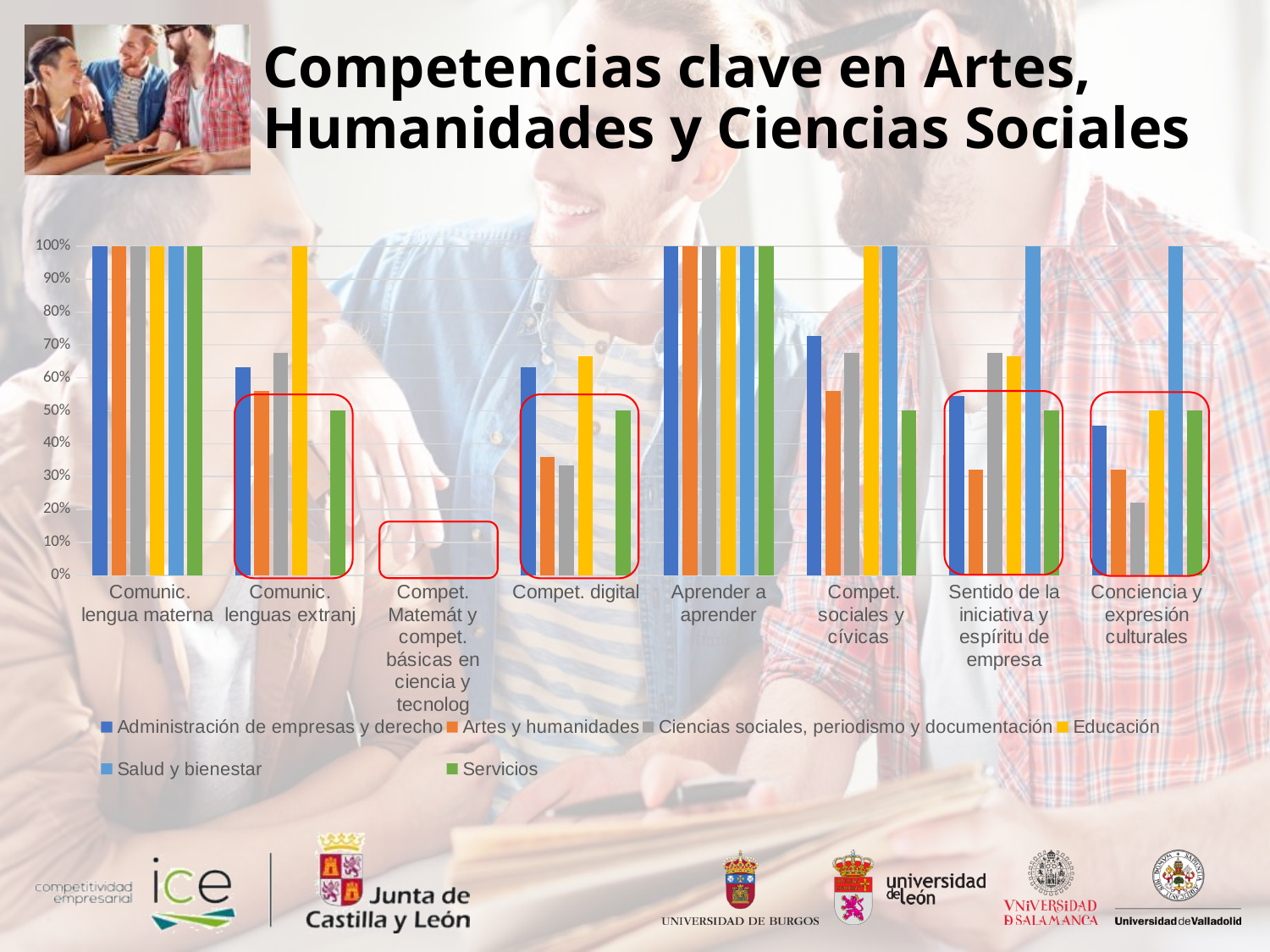
Which series has the lowest value in the Sentido de la iniciativa y espíritu de empresa category? Artes y humanidades What is the value for Salud y bienestar in the Conciencia y expresión culturales category? 100% How many series does the legend list? 6 What is the value for Servicios in the Compet. digital category? 50% Which series has the highest value in the Sentido de la iniciativa y espíritu de empresa category? Salud y bienestar What kind of chart is shown on the slide? Bar chart What colour represents the Educación series in the legend? Yellow What is the value for Educación in the Comunic. lengua materna category? 100% Is the value for Artes y humanidades in the Compet. digital category greater or less than 40%? less In the Compet. digital category, which is larger: Educación or Servicios? Educación Is the value for Ciencias sociales, periodismo y documentación in the Conciencia y expresión culturales category greater or less than 30%? less How many competency categories are shown along the x axis? 8